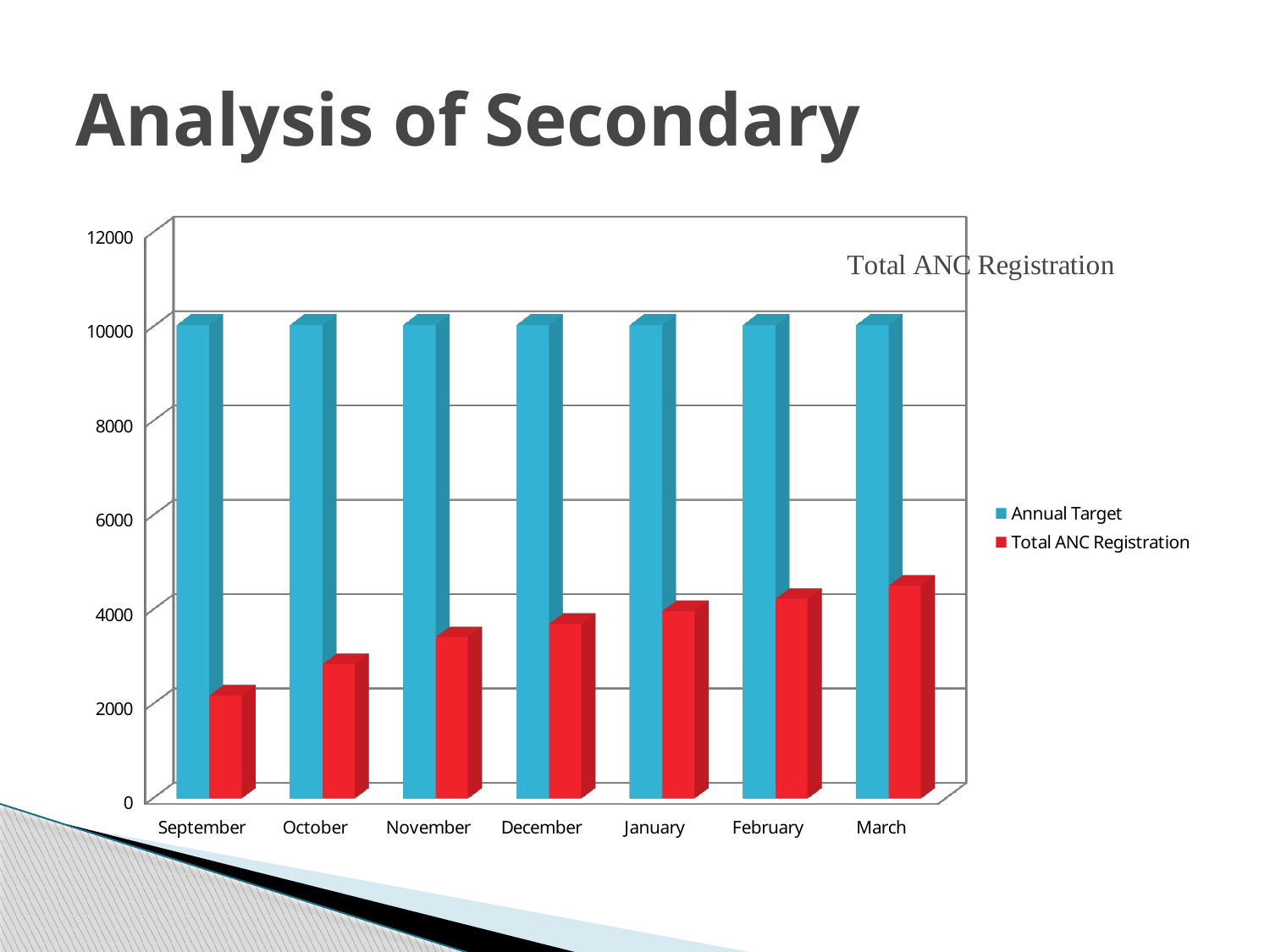
What kind of chart is shown on the slide? Bar chart Which series is shown in red? Total ANC Registration Is the Total ANC Registration for October greater or less than 2000? greater Which month has the lowest Total ANC Registration? September Does Total ANC Registration rise or fall from September to March? Rise Which month has the highest Total ANC Registration? March How many series does the legend list? 2 Is the Total ANC Registration for March greater or less than 6000? less Is the Total ANC Registration for September greater or less than 4000? less How many months are shown on the x axis? 7